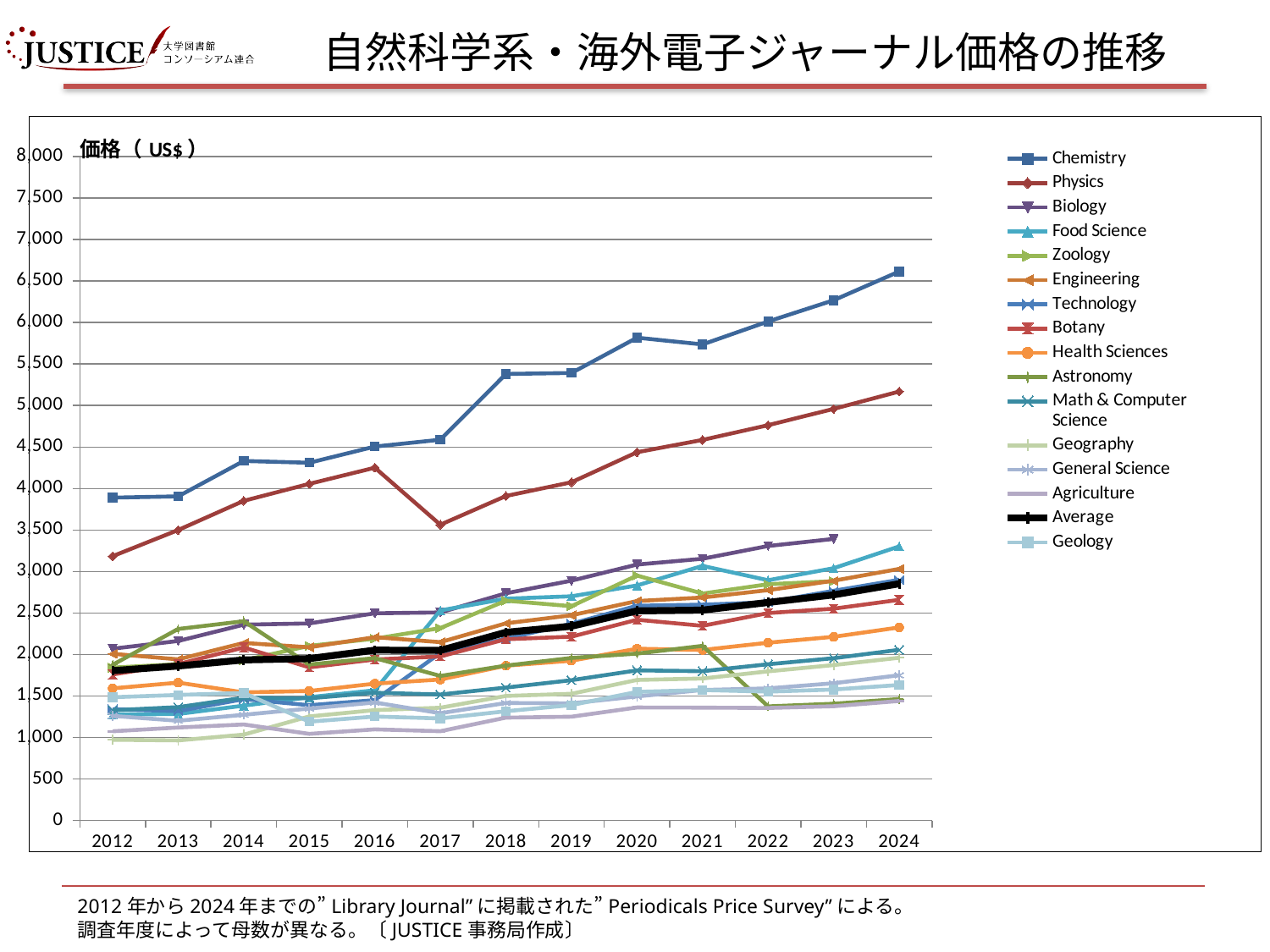
Which series has the highest value in 2024? Chemistry Does the Chemistry series generally rise or fall from 2012 to 2024? rise Is the value for Chemistry in 2024 greater or less than 6,000? greater Is the value for Physics in 2024 greater or less than 5,000? greater Which series has the second-highest value in 2024? Physics What kind of chart is shown on the slide? line chart What is the label shown on the vertical axis of the chart? 価格 ( US$ ) How many years are plotted along the x axis? 13 Is the value for Average in 2024 greater or less than 2,500? greater How many series does the legend list? 16